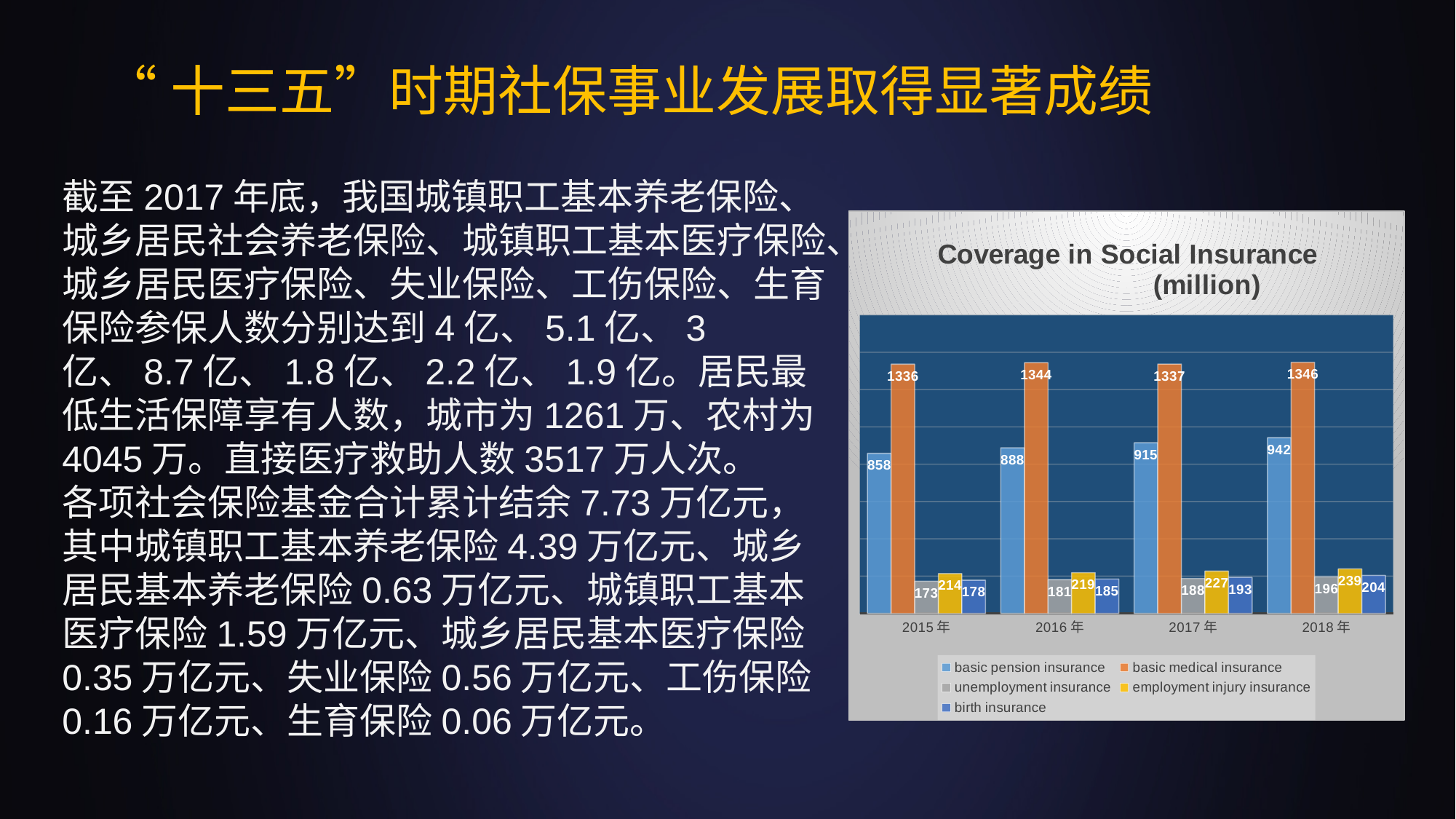
What is the value for birth insurance in 2016? 185 Which is larger in 2017: employment injury insurance or birth insurance? employment injury insurance What is the value for basic medical insurance in 2018? 1346 What is the difference between basic pension insurance in 2018 and in 2015? 84 Which series has the highest value in 2018? basic medical insurance How many years are shown on the x axis? 4 Which series has the lowest value in 2015? unemployment insurance Does the value for unemployment insurance rise or fall from 2015 to 2018? rise What is the value for basic pension insurance in 2015? 858 What is the value for employment injury insurance in 2017? 227 What kind of chart is shown? bar chart How many series does the legend list? 5